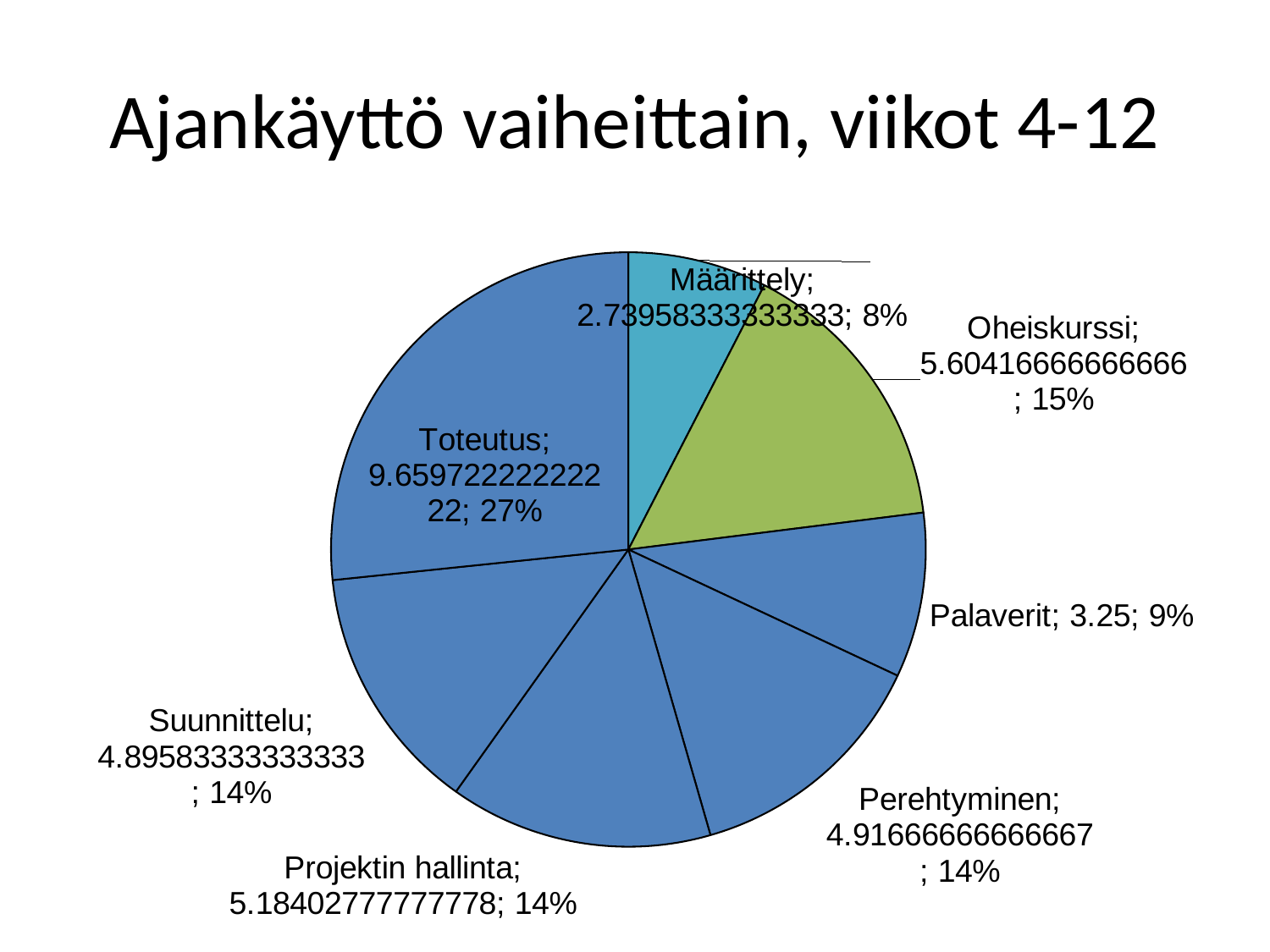
What is the value shown for Palaverit? 3.25 What share of the pie does Toteutus represent? 27% Which category has the smallest slice of the pie? Määrittely What is the difference between the value for Oheiskurssi and the value for Palaverit? 2.35416666666666 Which category has the largest slice of the pie? Toteutus What kind of chart is shown on the slide? pie chart What is the value shown for Projektin hallinta? 5.18402777777778 Which is larger, the value for Toteutus or the value for Oheiskurssi? Toteutus What share of the pie does Palaverit represent? 9% What is the title of the chart? Ajankäyttö vaiheittain, viikot 4-12 How many slices does the pie chart have? 7 What share of the pie does Oheiskurssi represent? 15%